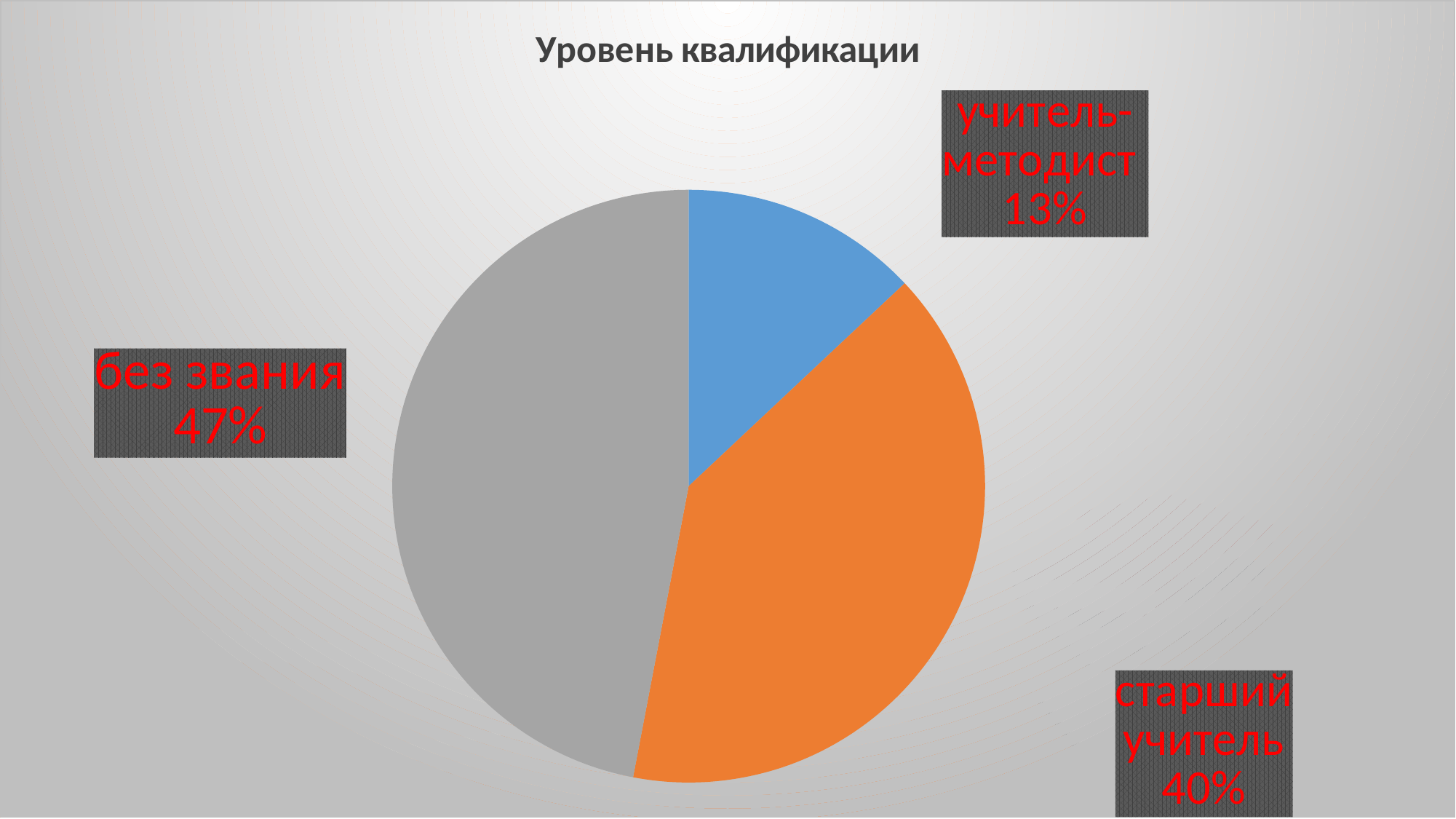
What share of the pie is labelled "учитель-методист"? 13% Which is larger, the share for "старший учитель" or the share for "учитель-методист"? старший учитель Which category has the smallest share of the pie? учитель-методист Which category has the largest share of the pie? без звания What colour is the slice for "старший учитель"? orange What type of chart is shown on the slide? pie chart What is the difference in percentage points between "без звания" and "старший учитель"? 7 What share of the pie is labelled "без звания"? 47% What is the difference in percentage points between "старший учитель" and "учитель-методист"? 27 What is the title of the chart? Уровень квалификации What share of the pie is labelled "старший учитель"? 40% How many slices does the pie chart have? 3